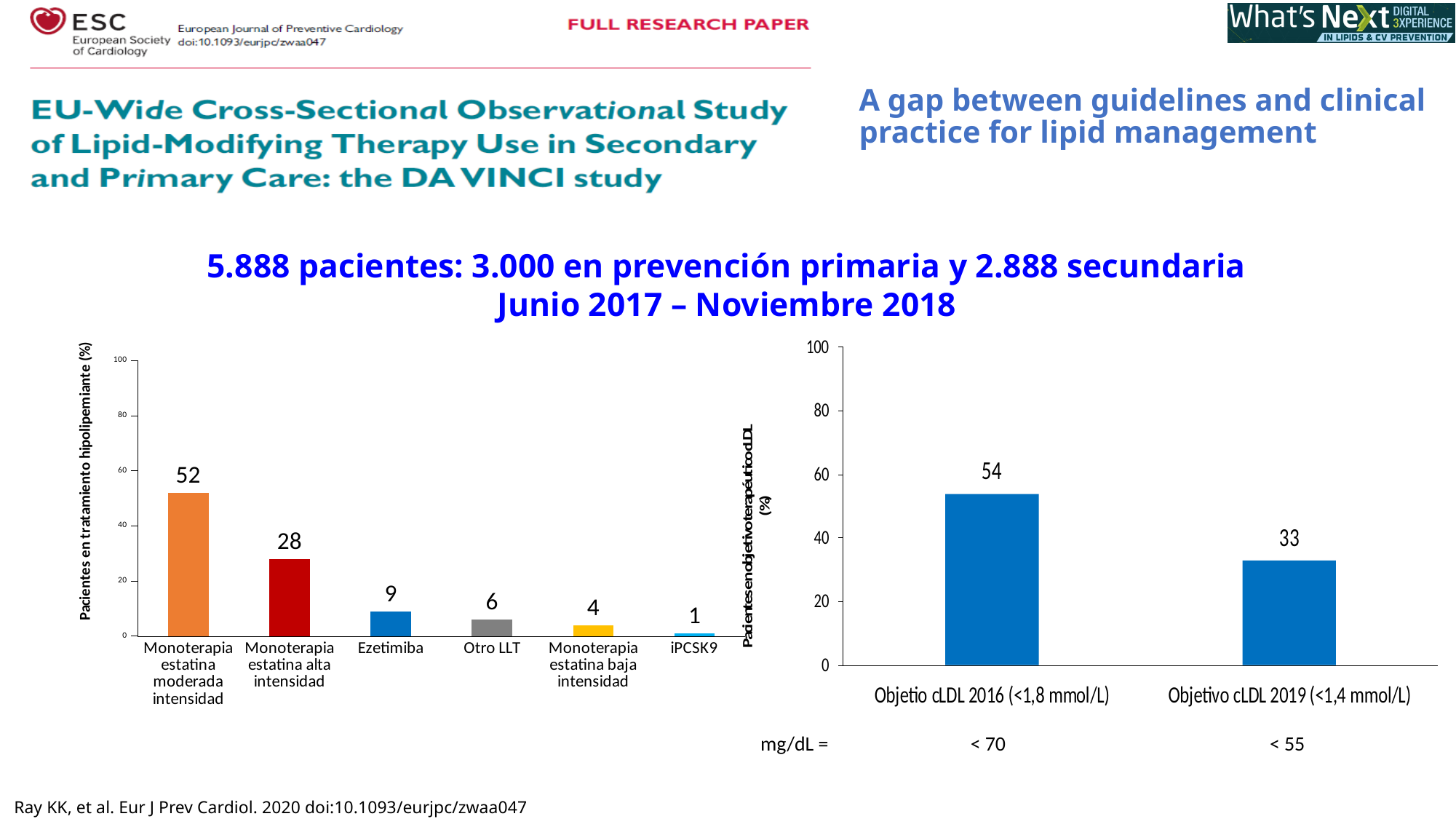
In the left chart, which category has the highest value? Monoterapia estatina moderada intensidad In the right chart, is the value for Objetio cLDL 2016 (<1,8 mmol/L) greater or less than 40? greater What kind of chart is the left chart? Bar chart In the left chart, what is the value for Monoterapia estatina moderada intensidad? 52 In the left chart, which category has the lowest value? iPCSK9 In the right chart, what is the difference between the 2016 and 2019 cLDL objective values? 21 In the left chart, what colour is the bar for Monoterapia estatina alta intensidad? Red How many categories are shown in the left chart? 6 In the right chart, what is the value for Objetivo cLDL 2019 (<1,4 mmol/L)? 33 In the left chart, which is larger: Otro LLT or Monoterapia estatina baja intensidad? Otro LLT In the left chart, what is the difference between Monoterapia estatina moderada intensidad and Monoterapia estatina alta intensidad? 24 In the left chart, what is the value for Ezetimiba? 9